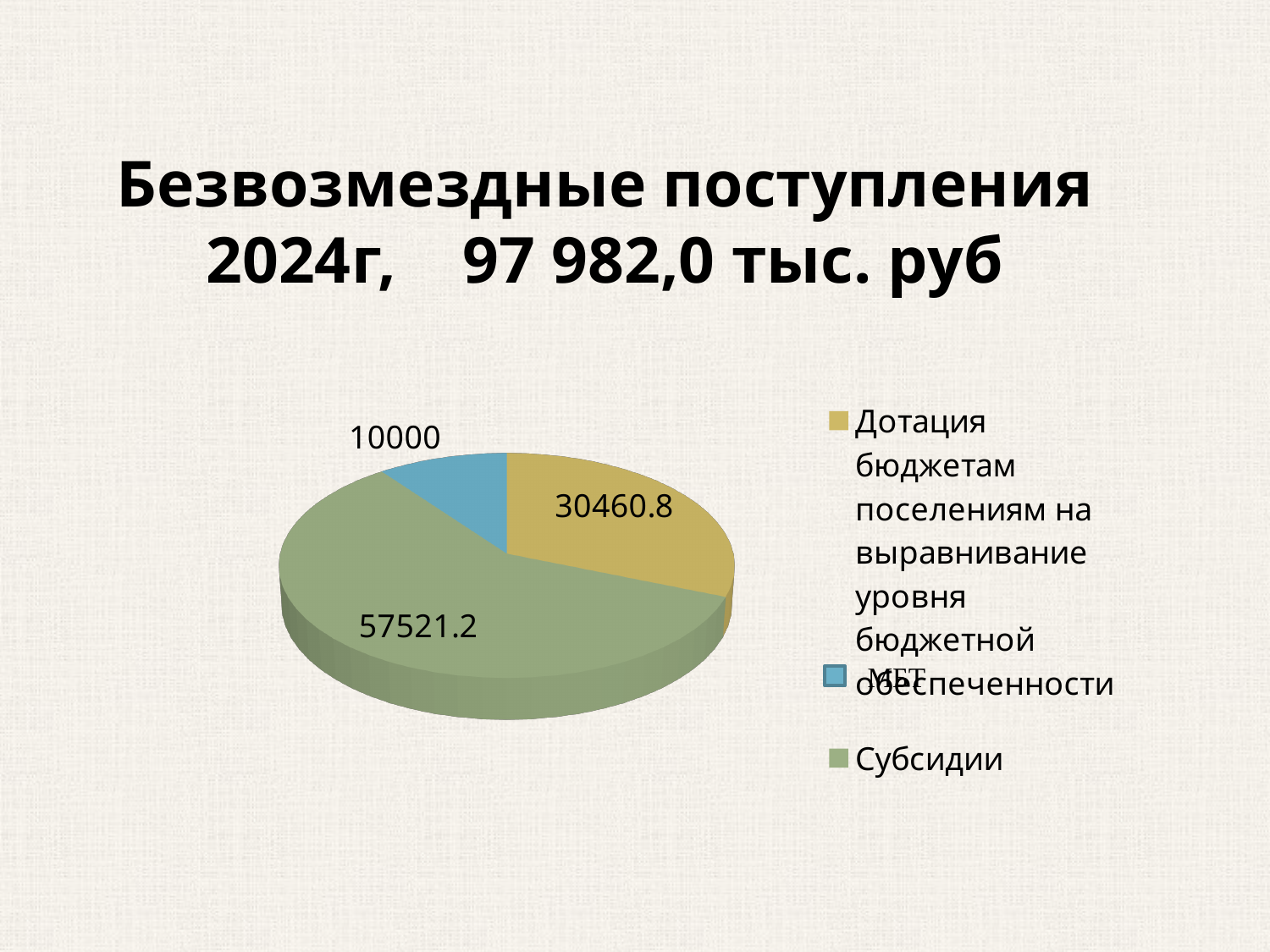
Which is larger, the Дотация slice or the МБТ slice? Дотация What is the difference between the Дотация value and the МБТ value? 20460.8 What is the value of the МБТ slice? 10000 What is the value of the Субсидии slice? 57521.2 Which category has the smallest slice of the pie? МБТ Which category has the largest slice of the pie? Субсидии How many slices does the pie chart have? 3 What is the title of the slide containing the chart? Безвозмездные поступления 2024г, 97 982,0 тыс. руб What is the value of the slice for Дотация бюджетам поселениям на выравнивание уровня бюджетной обеспеченности? 30460.8 What is the difference between the Субсидии value and the Дотация value? 27060.4 What kind of chart is shown on the slide? Pie chart